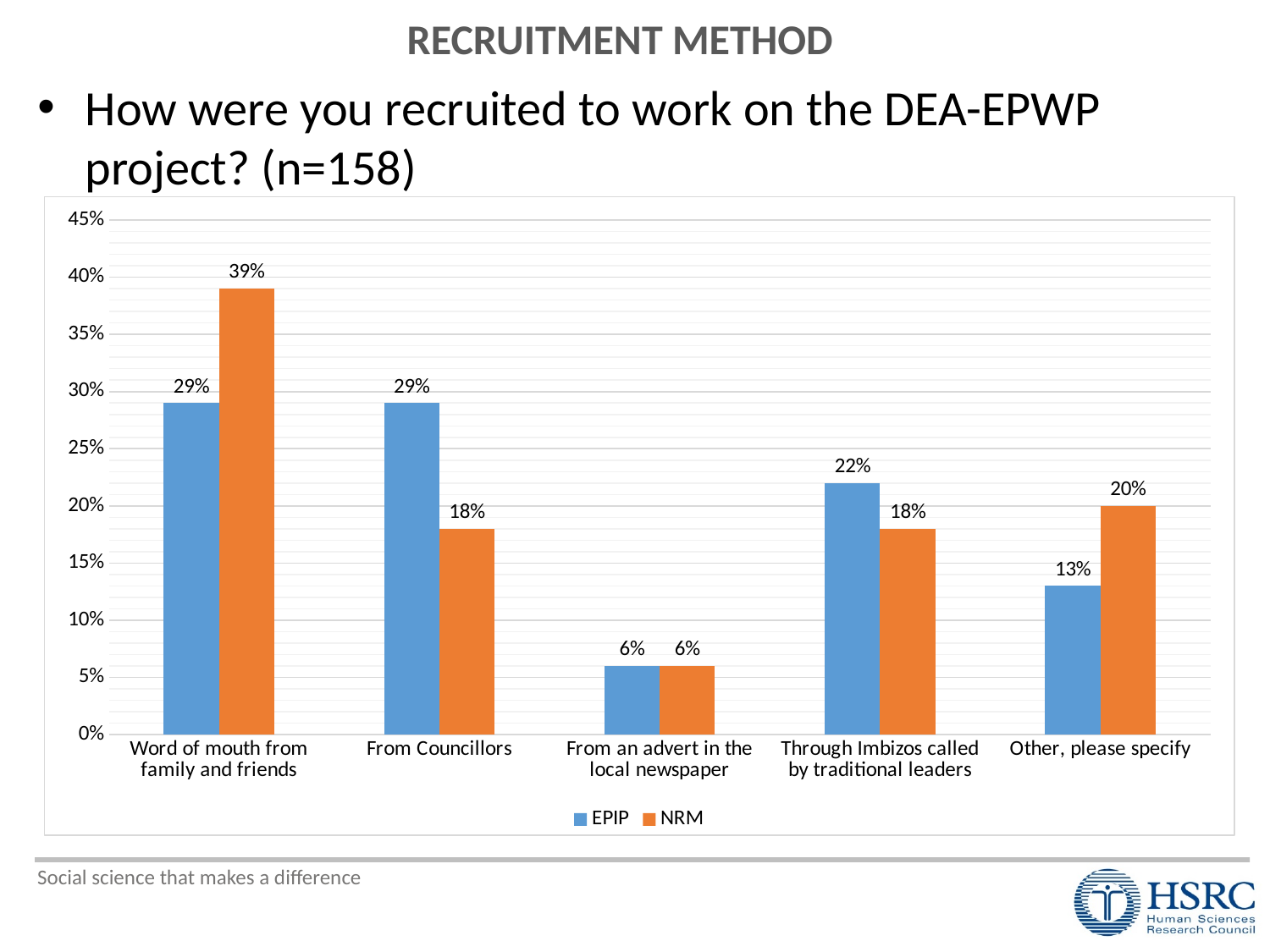
Which category has the highest NRM value? Word of mouth from family and friends How many recruitment method categories are shown on the x axis? 5 Which series is shown in orange in the legend? NRM What is the EPIP value for 'From Councillors'? 29% For 'From Councillors', which series has the larger value, EPIP or NRM? EPIP Which category has the lowest EPIP value? From an advert in the local newspaper How many series does the legend list? 2 What is the difference between the NRM and EPIP values for 'Word of mouth from family and friends'? 10% What is the NRM value for 'Word of mouth from family and friends'? 39% What kind of chart is shown on the slide? Bar chart What is the EPIP value for 'Through Imbizos called by traditional leaders'? 22% What is the NRM value for 'Other, please specify'? 20%